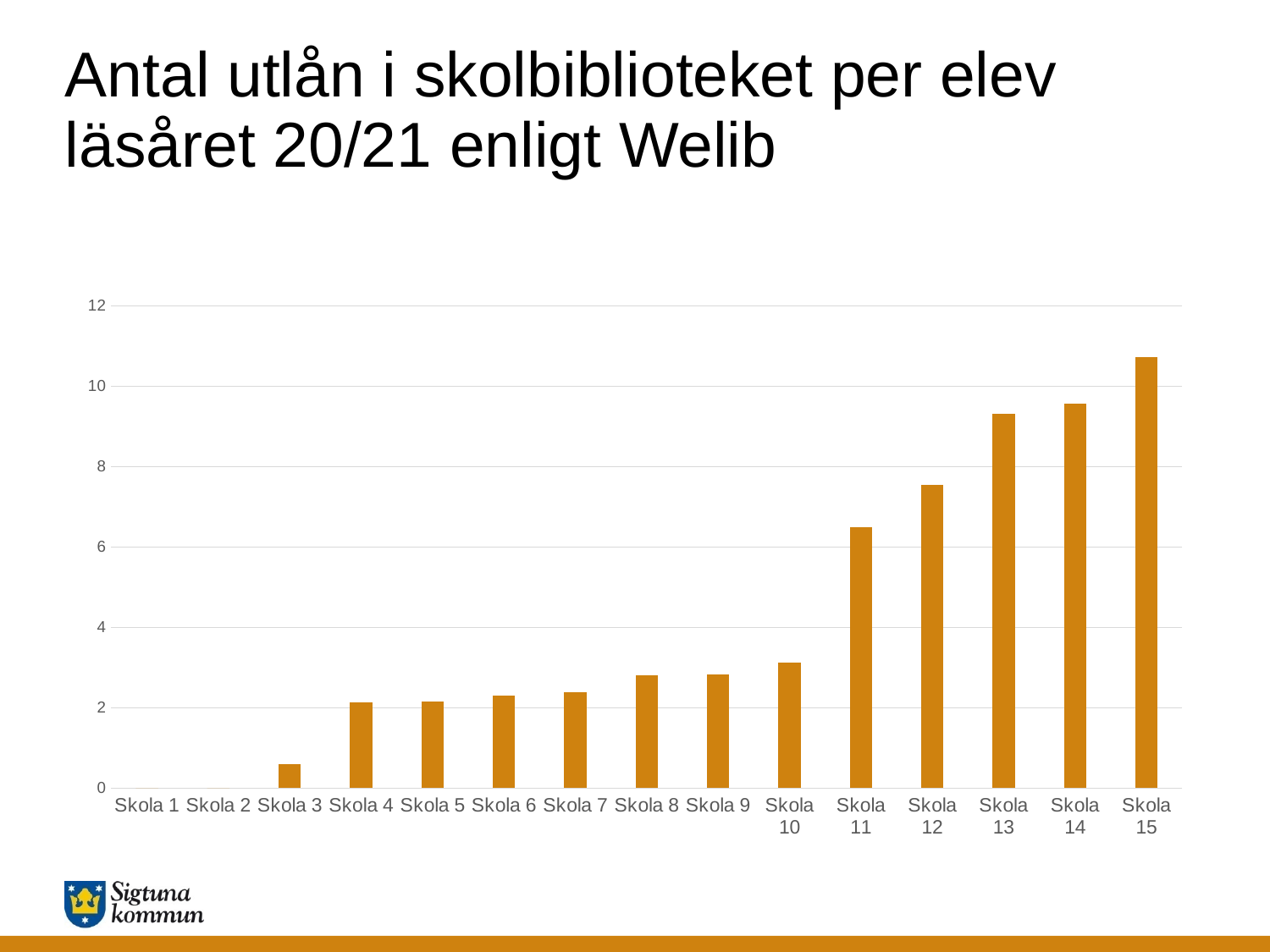
Which school has the highest number of loans per pupil? Skola 15 What is the title of the slide? Antal utlån i skolbiblioteket per elev läsåret 20/21 enligt Welib Is the value for Skola 13 greater or less than 8? greater How many schools (categories) are shown on the x axis? 15 Which has the larger value, Skola 11 or Skola 12? Skola 12 Is the value for Skola 15 greater or less than 10? greater Is the value for Skola 11 greater or less than 6? greater Which has the larger value, Skola 10 or Skola 11? Skola 11 What kind of chart is shown on the slide? Bar chart Do the values generally rise or fall from Skola 1 to Skola 15? Rise